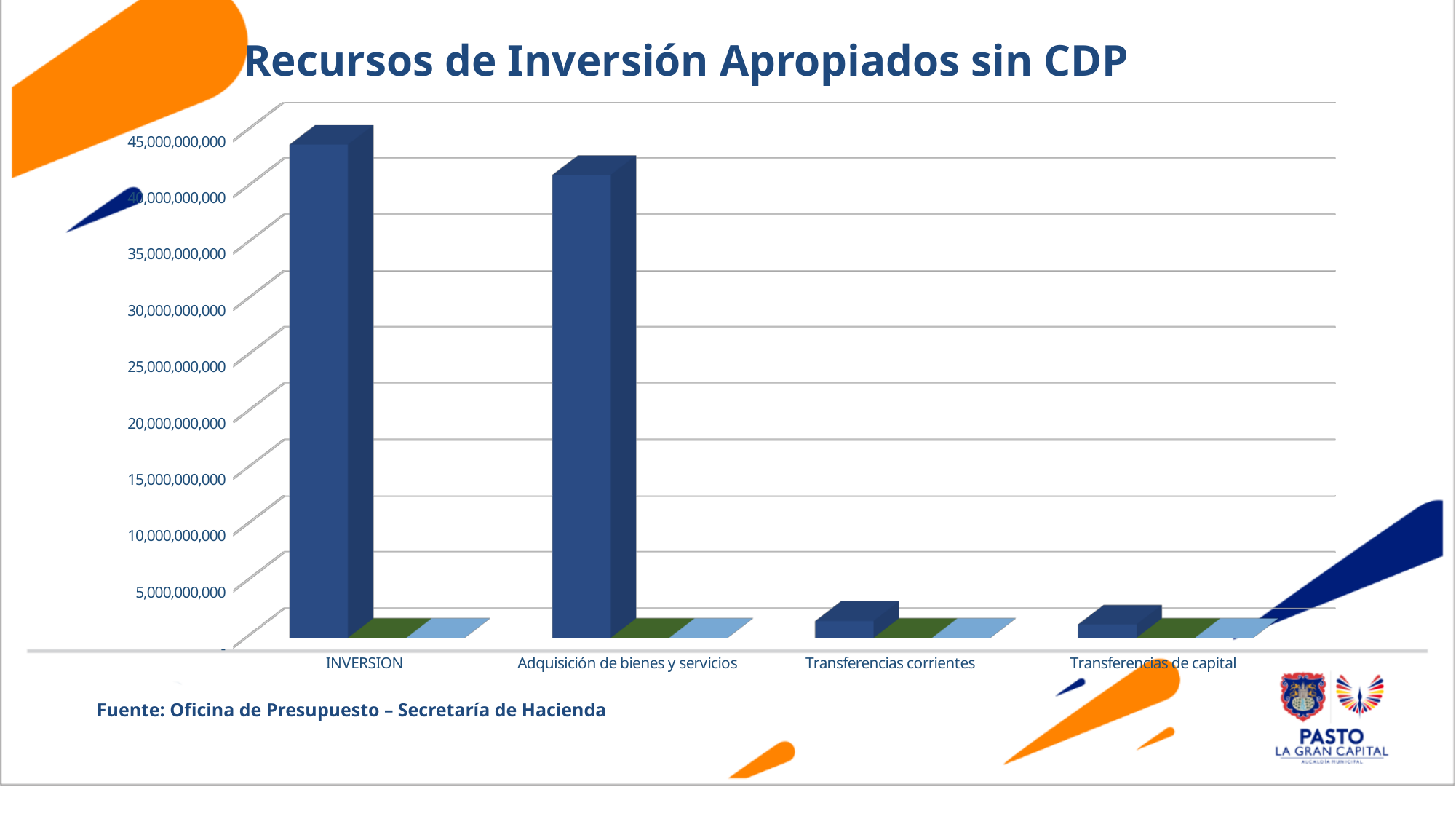
Is the dark blue bar for INVERSION greater or less than 40,000,000,000? greater What is the highest value labelled on the vertical axis of the chart? 45,000,000,000 Which category has the tallest dark blue bar? INVERSION What kind of chart is shown on the slide? bar chart Do the dark blue bars generally rise or fall from left to right along the x axis? fall What is the title of the chart? Recursos de Inversión Apropiados sin CDP Is the dark blue bar for Transferencias de capital greater or less than 10,000,000,000? less How many categories are shown on the x axis of the chart? 4 Is the dark blue bar for Transferencias corrientes greater or less than 5,000,000,000? less Which dark blue bar is taller: Adquisición de bienes y servicios or Transferencias corrientes? Adquisición de bienes y servicios Which dark blue bar is taller: INVERSION or Adquisición de bienes y servicios? INVERSION